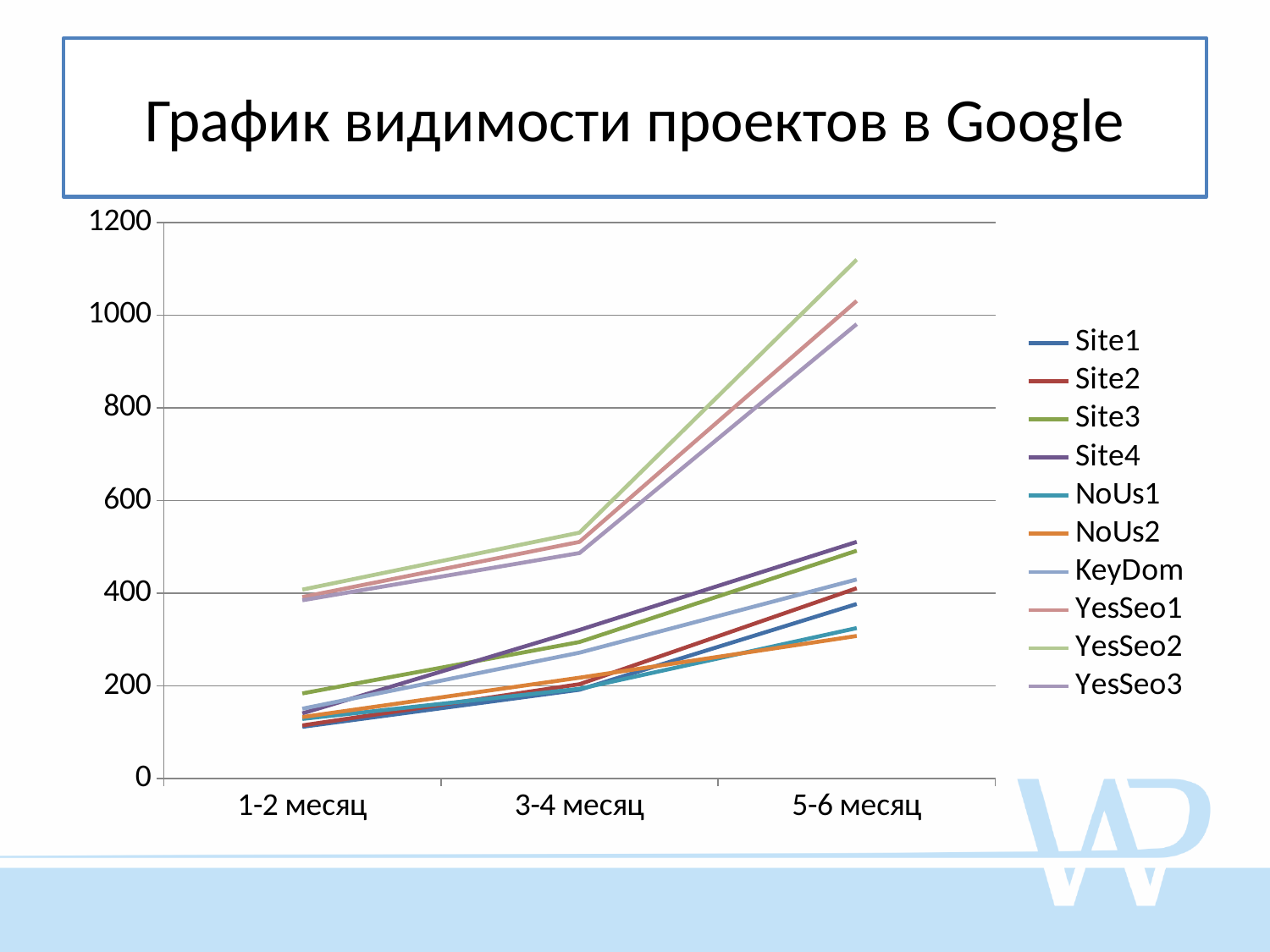
Do the values for YesSeo2 rise or fall from 1-2 месяц to 5-6 месяц? rise Is the value for Site4 at 5-6 месяц greater or less than 400? greater Which is larger at 5-6 месяц, the value for YesSeo2 or the value for Site1? YesSeo2 Is the value for YesSeo2 at 5-6 месяц greater or less than 1000? greater What kind of chart is shown on the slide? line chart Is the value for YesSeo3 at 5-6 месяц greater or less than 1000? less Which series has the highest value at 5-6 месяц? YesSeo2 What is the title of the slide containing the chart? График видимости проектов в Google How many categories are shown on the x axis? 3 How many series does the legend list? 10